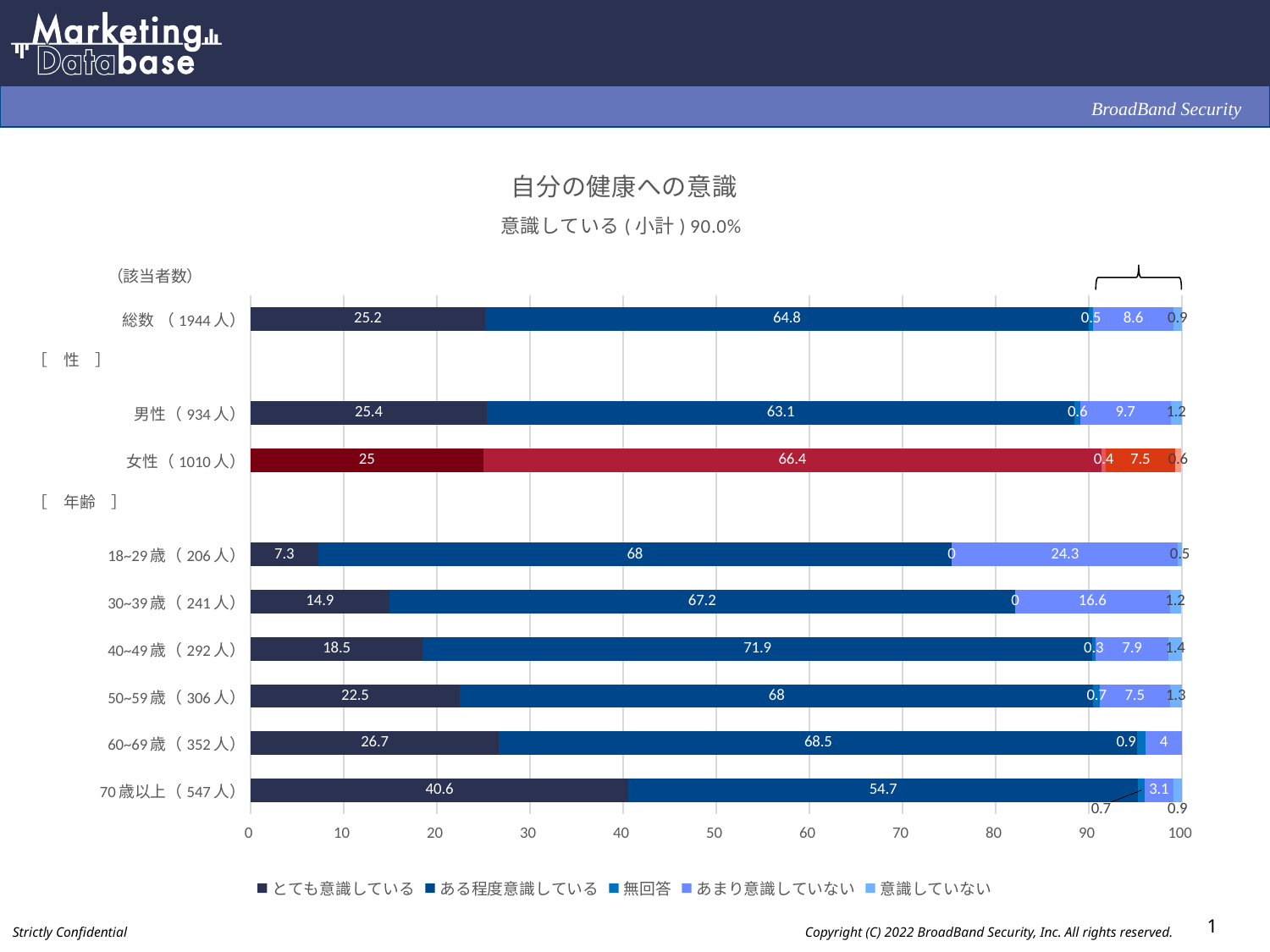
How many categories (bars) are plotted in the chart? 9 Which is larger, the ある程度意識している value for 男性 or for 女性? 女性 What is the value of 意識していない for 男性? 1.2 What is the value of あまり意識していない for 18~29歳? 24.3 What is the value of とても意識している for 70歳以上? 40.6 Which category has the lowest value for とても意識している? 18~29歳 What is the difference between the とても意識している values for 男性 and 女性? 0.4 Which category has the highest value for とても意識している? 70歳以上 How many series does the legend list? 5 What type of chart is shown on the slide? stacked bar chart What is the subtotal percentage for 意識している shown under the chart title? 90.0% What is the value of ある程度意識している for 40~49歳? 71.9